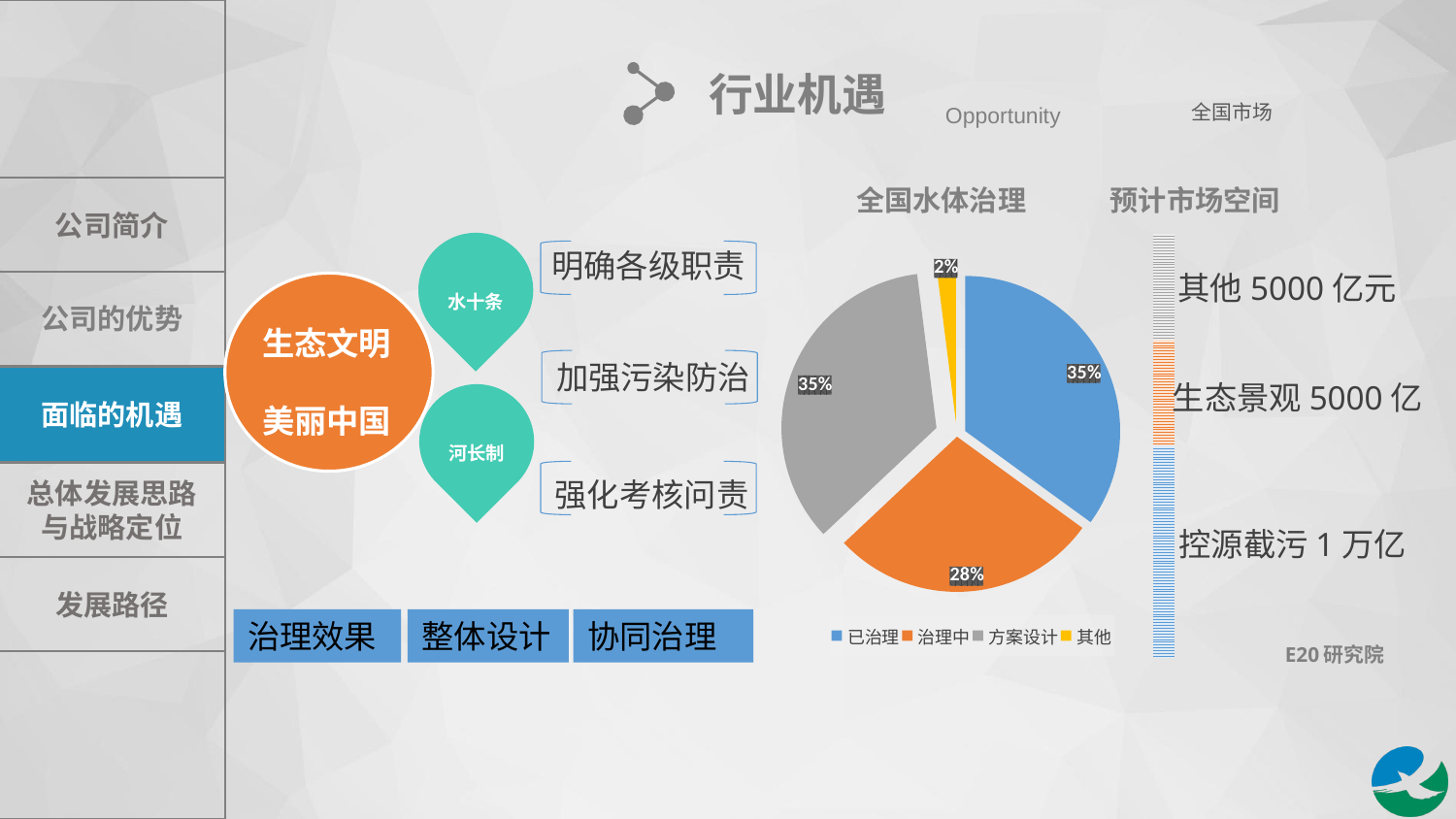
In the 全国水体治理 pie chart, which category has the smallest slice? 其他 How many slices does the 全国水体治理 pie chart have? 4 In the 全国水体治理 pie chart, what is the difference between the shares of 方案设计 and 治理中? 7% In the 全国水体治理 pie chart, what share is labelled for 治理中? 28% What kind of chart is shown under the heading 全国水体治理? pie chart In the 全国水体治理 pie chart, what share is labelled for 其他? 2% In the 全国水体治理 pie chart, what is the difference between the shares of 治理中 and 其他? 26% How many entries does the legend of the 全国水体治理 pie chart list? 4 In the 全国水体治理 pie chart, what share is labelled for 已治理? 35% In the 全国水体治理 pie chart, which is larger: 已治理 or 治理中? 已治理 In the 全国水体治理 pie chart, what colour is the 治理中 slice? orange In the 全国水体治理 pie chart, what share is labelled for 方案设计? 35%